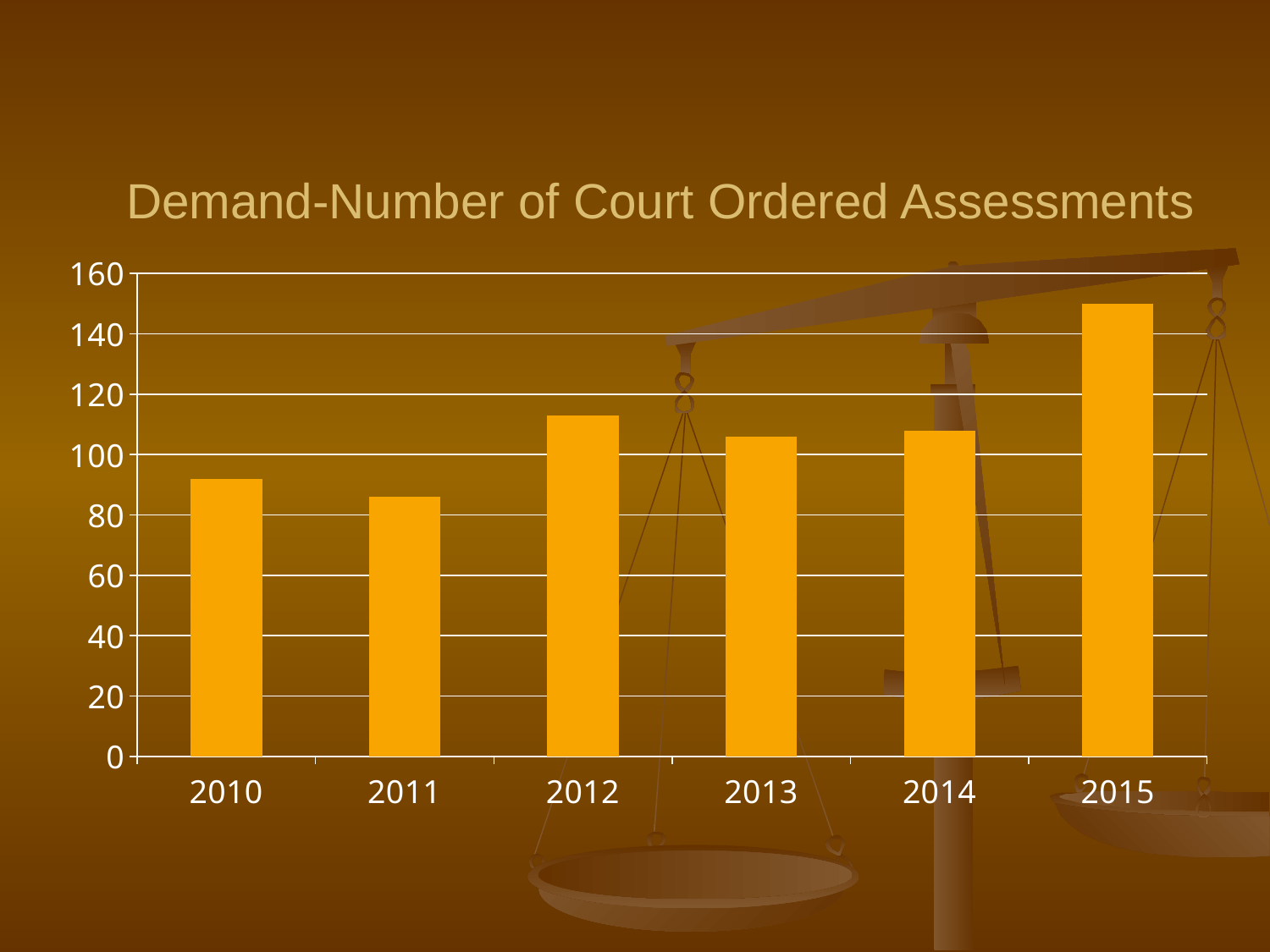
Is the value for 2015 higher or lower than the value for 2010? higher What type of chart is shown on the slide? bar chart Is the value for 2014 greater or less than 120? less Which year has a higher value, 2012 or 2013? 2012 Is the value for 2011 greater or less than 100? less Which year has the lowest number of court ordered assessments? 2011 How many years are shown on the x axis of the chart? 6 Is the value for 2012 greater or less than 100? greater Which year has a higher value, 2010 or 2011? 2010 Which year has the highest number of court ordered assessments? 2015 What is the title of the chart? Demand-Number of Court Ordered Assessments